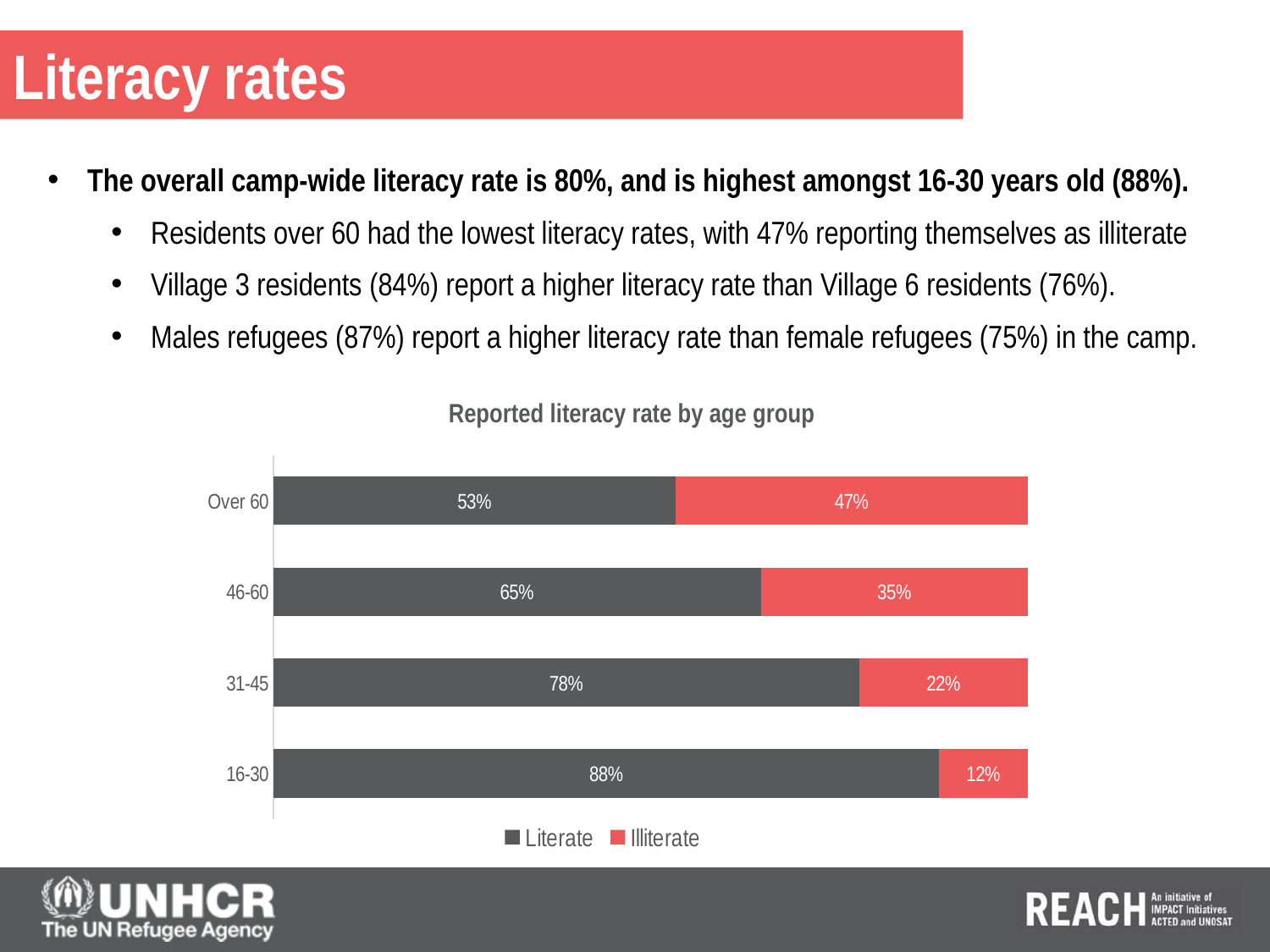
Which is larger, the illiterate share for 46-60 or for 31-45? 46-60 How many series does the legend list? 2 What is the title of the chart? Reported literacy rate by age group How many age groups are shown in the chart? 4 What is the literate share for the 16-30 age group? 88% Which age group has the lowest literate share? Over 60 What is the literate share for the 46-60 age group? 65% What is the illiterate share for the Over 60 age group? 47% What is the illiterate share for the 31-45 age group? 22% Which age group has the highest literate share? 16-30 What kind of chart is shown? Stacked bar chart What is the difference between the literate shares of the 16-30 and Over 60 age groups? 35%